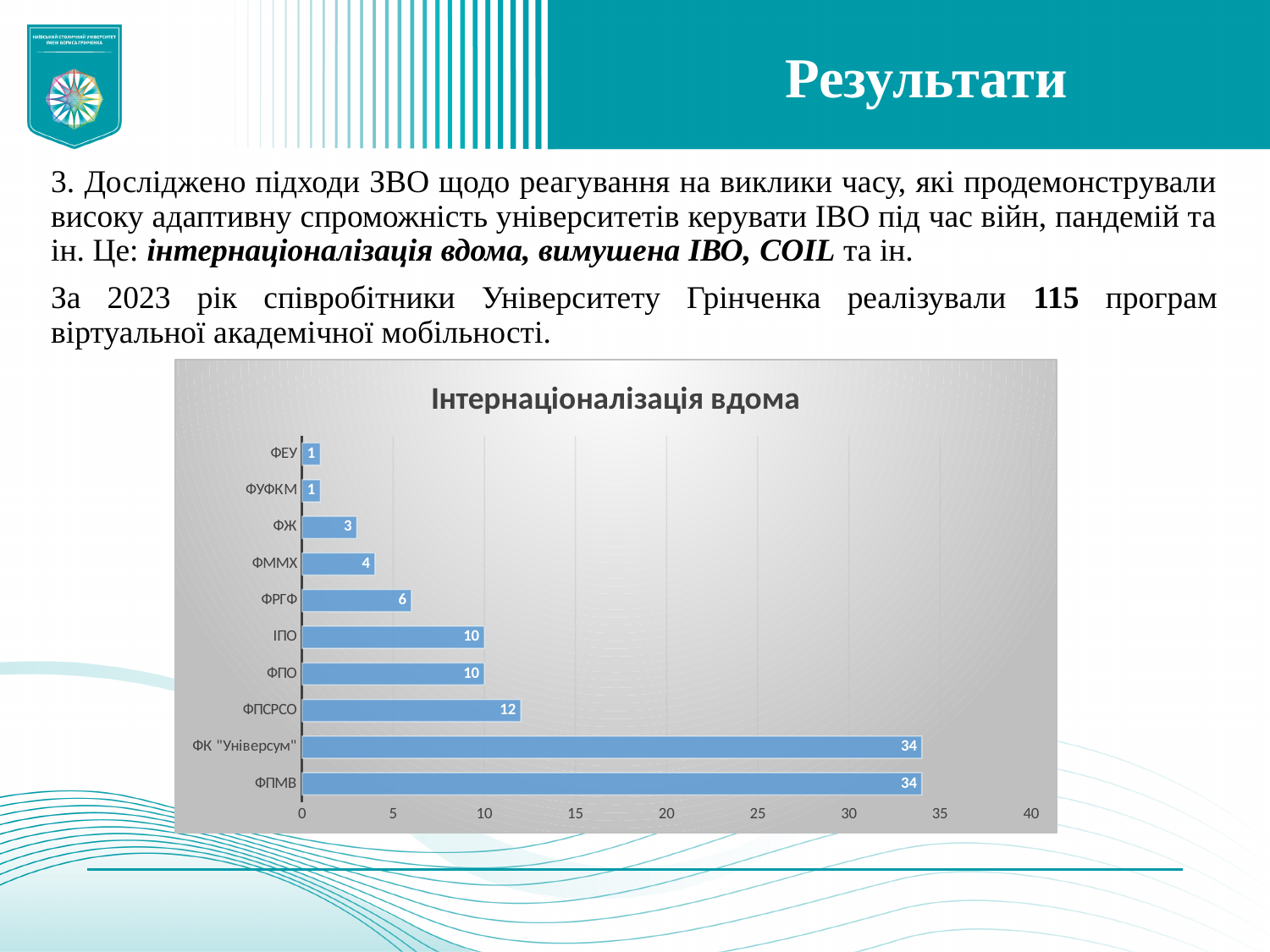
What is the value for ФРГФ in the chart? 6 What is the difference between the values for ІПО and ФММХ? 6 What is the value for ФПСРСО in the chart "Інтернаціоналізація вдома"? 12 What kind of chart is shown on the slide? bar chart What is the title of the chart on the slide? Інтернаціоналізація вдома What is the value for ФЖ in the chart? 3 Which is larger, the value for ФПСРСО or the value for ФПО? ФПСРСО What is the value for ФК "Універсум" in the chart? 34 What is the difference between the values for ФПМВ and ФПСРСО? 22 What is the value for ФММХ in the chart? 4 Is the value for ФПМВ greater or less than 30? greater How many categories are shown in the chart? 10